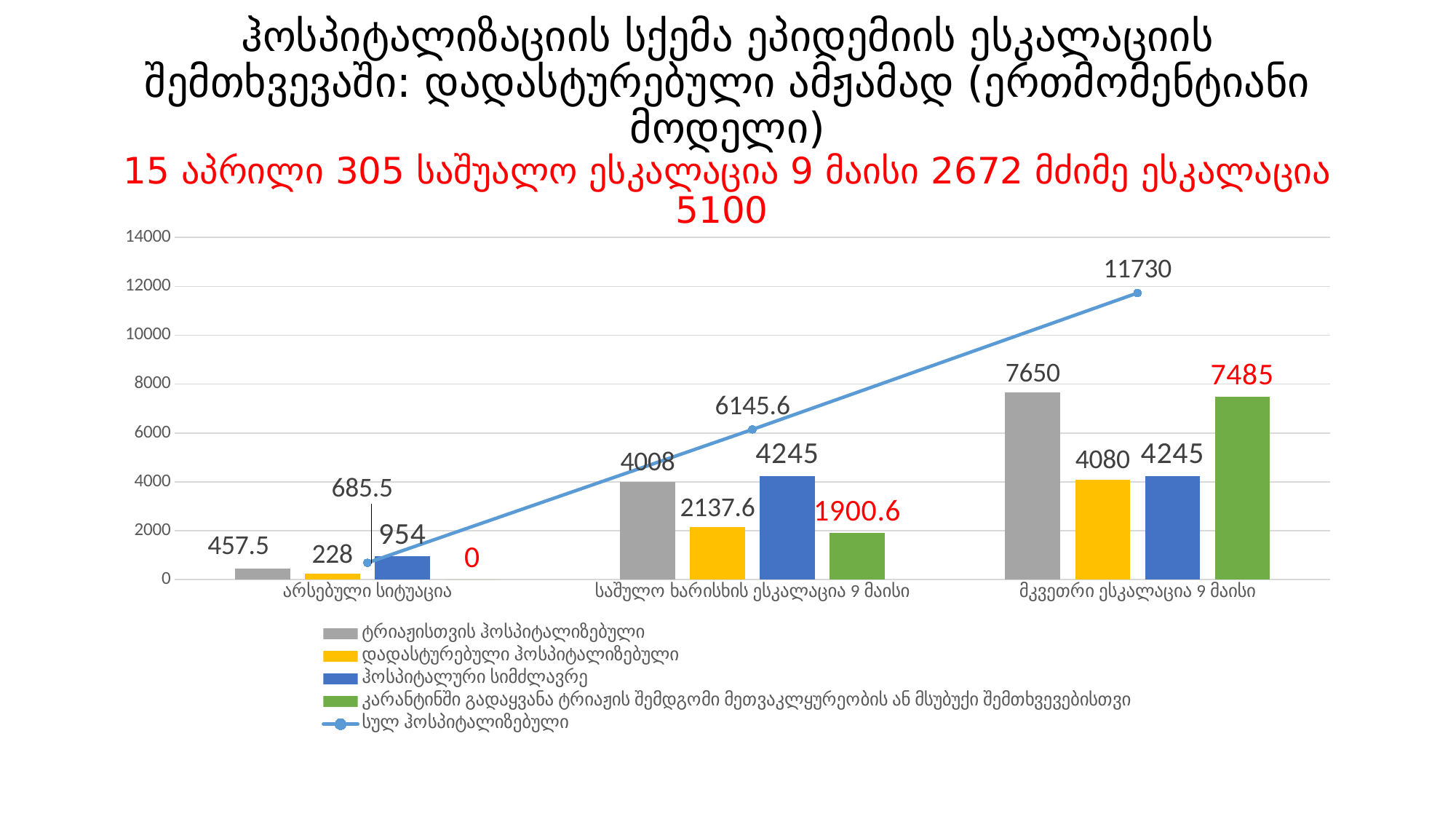
What is the difference between the ჰოსპიტალური სიმძლავრე (blue bar) value and the ტრიაჟისთვის ჰოსპიტალიზებული (gray bar) value for მკვეთრი ესკალაცია 9 მაისი? 3405 What is the value of დადასტურებული ჰოსპიტალიზებული (yellow bar) for არსებული სიტუაცია? 228 How many series does the legend list? 5 What kind of chart is shown on the slide? Combined bar and line chart Which category has the lowest value for the green bar (კარანტინში გადაყვანა)? არსებული სიტუაცია For საშუალო ხარისხის ესკალაცია 9 მაისი, which is larger: the blue bar (ჰოსპიტალური სიმძლავრე) or the yellow bar (დადასტურებული ჰოსპიტალიზებული)? ჰოსპიტალური სიმძლავრე (blue bar) Does the line series სულ ჰოსპიტალიზებული rise or fall from left to right across the categories? Rises Which category has the highest value for the line series სულ ჰოსპიტალიზებული? მკვეთრი ესკალაცია 9 მაისი What is the value of the line series სულ ჰოსპიტალიზებული for მკვეთრი ესკალაცია 9 მაისი? 11730 How many categories are shown on the x axis? 3 What is the value of the green bar (კარანტინში გადაყვანა) for მკვეთრი ესკალაცია 9 მაისი? 7485 What is the value of ტრიაჟისთვის ჰოსპიტალიზებული (gray bar) for საშუალო ხარისხის ესკალაცია 9 მაისი? 4008